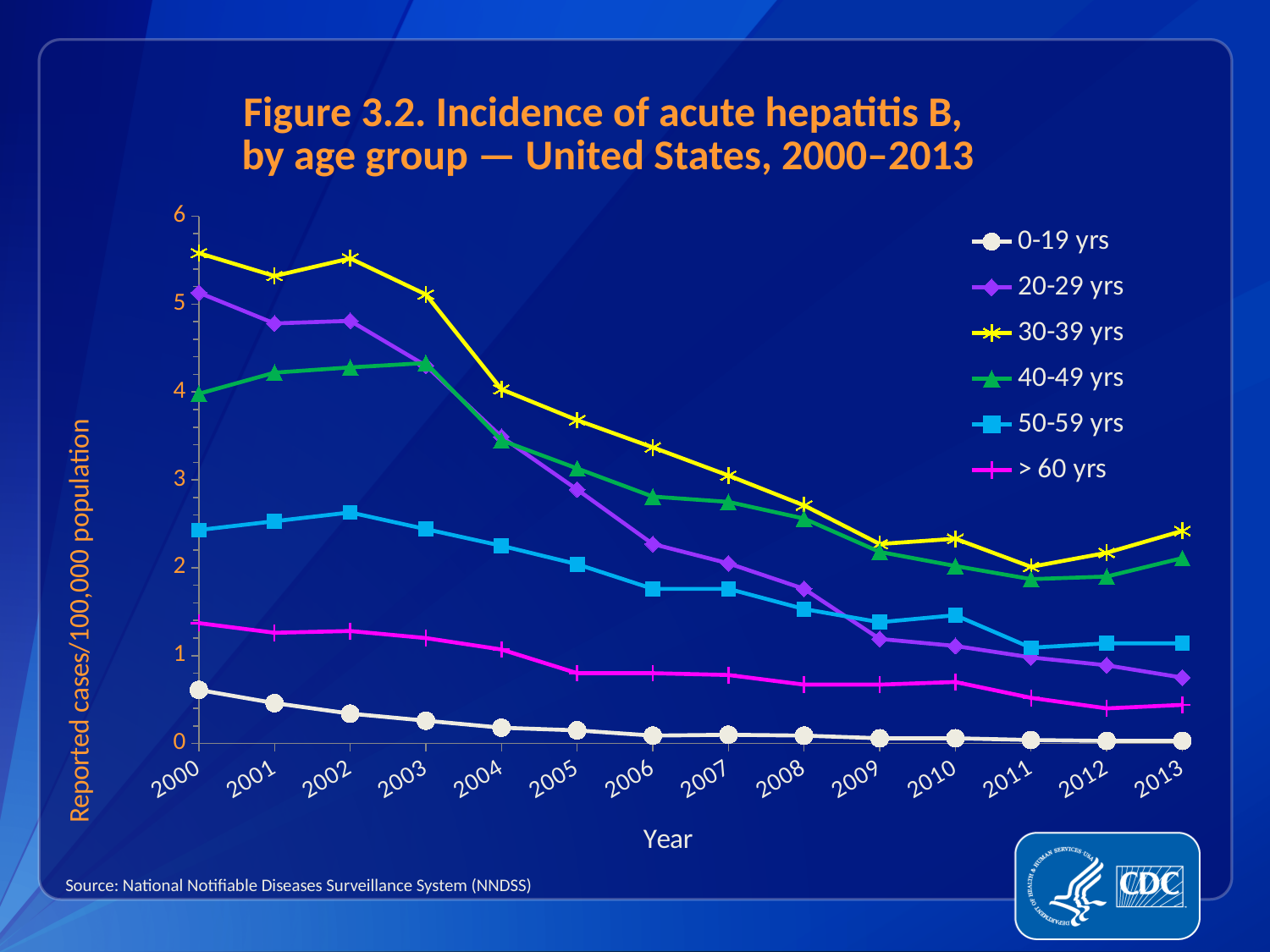
Does the incidence for the 30-39 yrs group rise or fall from 2000 to 2011? fall How many age groups does the legend list? 6 Which age group has the lowest incidence in 2013? 0-19 yrs Which age group has the highest incidence in 2000? 30-39 yrs Is the value for 30-39 yrs in 2000 greater or less than 5? greater Is the value for 20-29 yrs in 2013 greater or less than 1? less How many years are plotted along the x axis? 14 What kind of chart is shown on the slide? line chart In 2000, which is larger: the value for 20-29 yrs or the value for 40-49 yrs? 20-29 yrs What is the label on the y axis of the chart? Reported cases/100,000 population In 2013, which is larger: the value for 50-59 yrs or the value for 20-29 yrs? 50-59 yrs Is the value for 40-49 yrs in 2004 greater or less than 3? greater